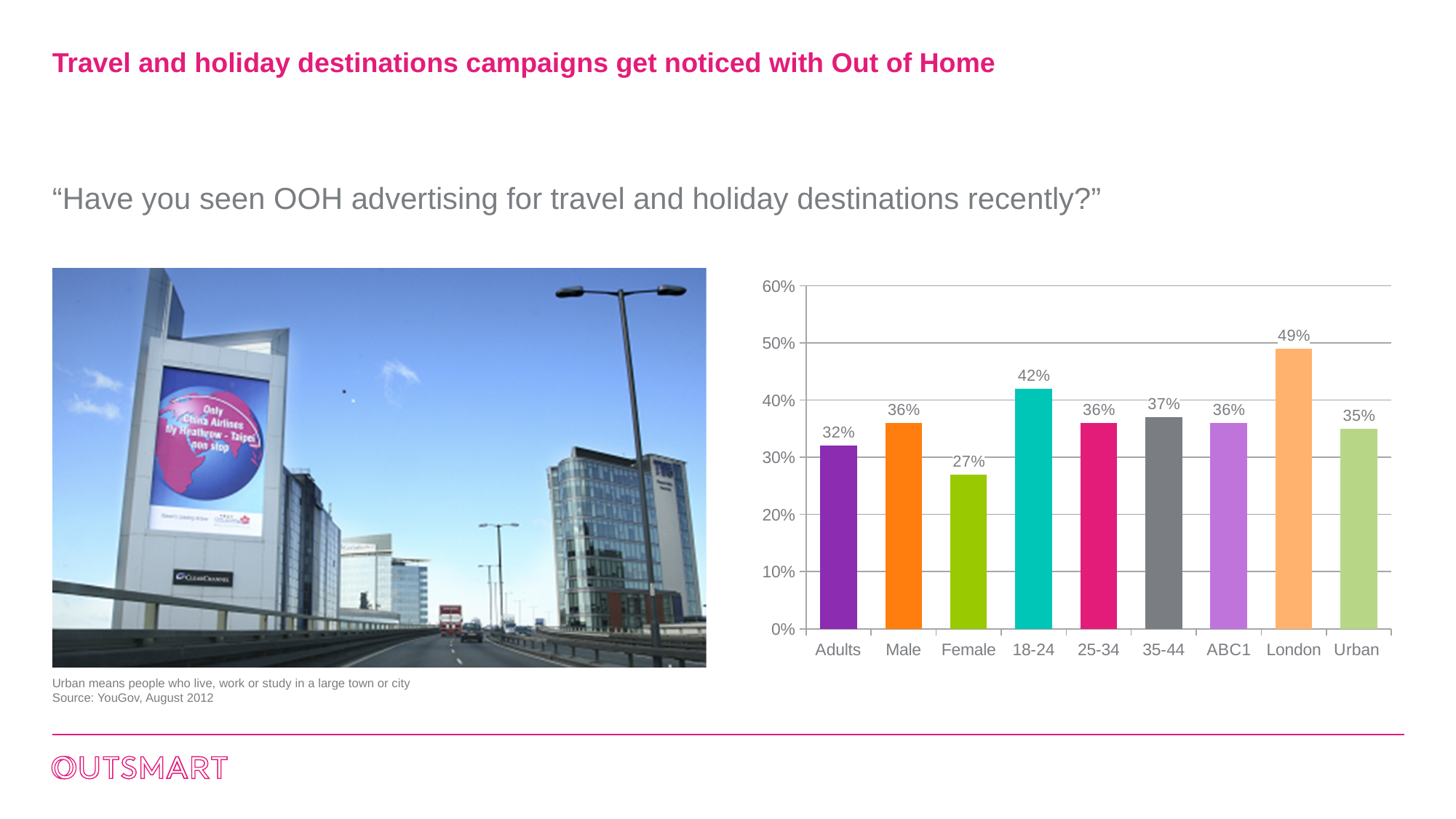
What is the highest value shown on the y axis? 60% What is the difference between the values for London and Female? 22% What is the value for 18-24? 42% What is the value for Adults? 32% Which is larger, the value for 18-24 or the value for 35-44? 18-24 What is the difference between the values for Male and Female? 9% Which category has the highest value? London What is the value for Female? 27% What is the value for London? 49% Which category has the lowest value? Female How many categories are shown on the x axis? 9 What kind of chart is shown on the slide? Bar chart